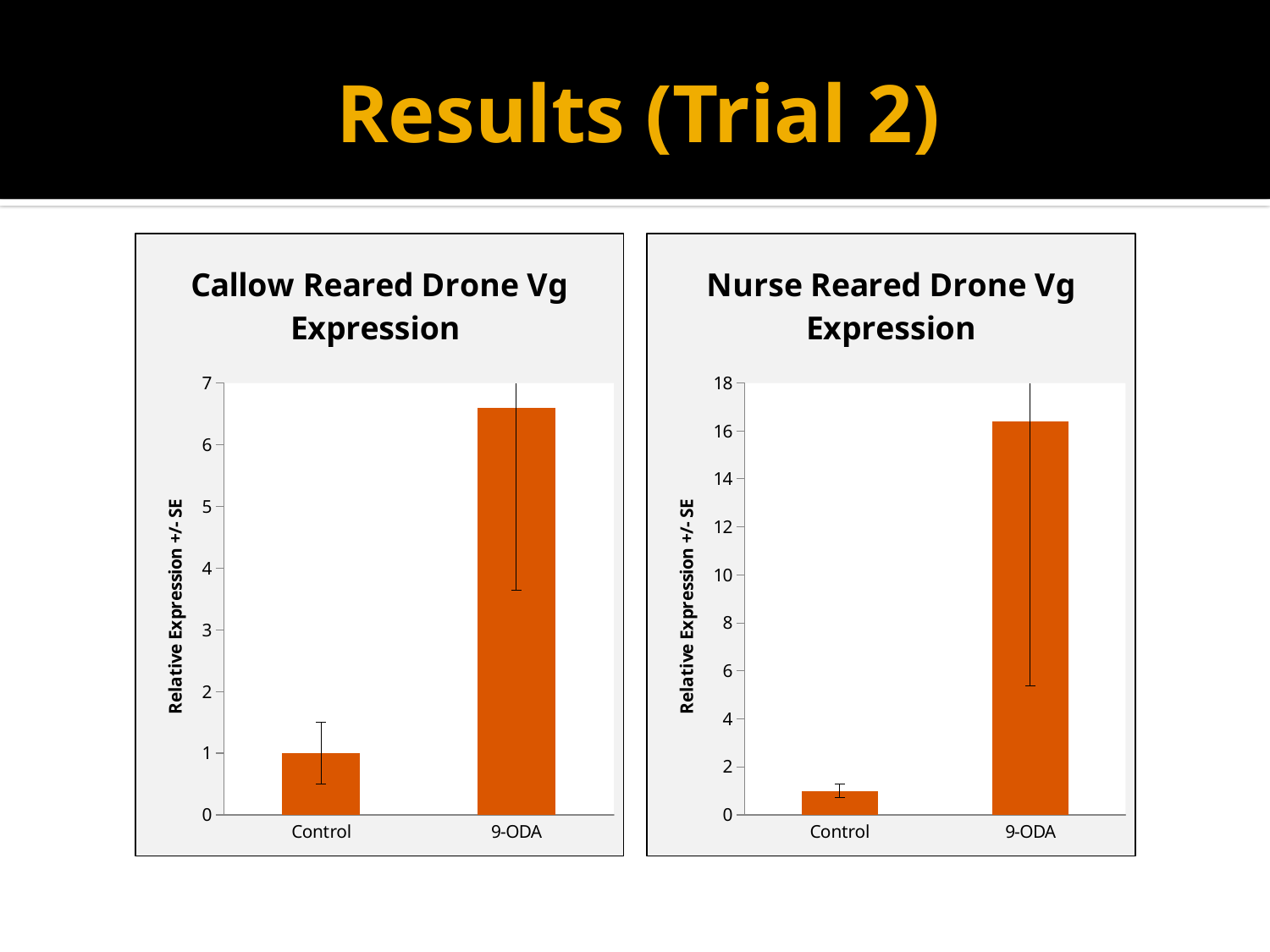
What is the maximum value shown on the y axis of the Callow Reared Drone Vg Expression chart? 7 In the Callow Reared Drone Vg Expression chart, which is larger, Control or 9-ODA? 9-ODA In the Callow Reared Drone Vg Expression chart, which category has the highest value? 9-ODA In the Nurse Reared Drone Vg Expression chart, is the value for 9-ODA greater or less than 16? greater In the Nurse Reared Drone Vg Expression chart, is the value for 9-ODA greater or less than 18? less What kind of chart is the Callow Reared Drone Vg Expression chart? bar chart What is the y-axis label of the Nurse Reared Drone Vg Expression chart? Relative Expression +/- SE In the Nurse Reared Drone Vg Expression chart, which category has the lowest value? Control How many categories are shown on the x axis of the Nurse Reared Drone Vg Expression chart? 2 In the Callow Reared Drone Vg Expression chart, is the value for 9-ODA greater or less than 6? greater In the Callow Reared Drone Vg Expression chart, what is the value for Control? 1